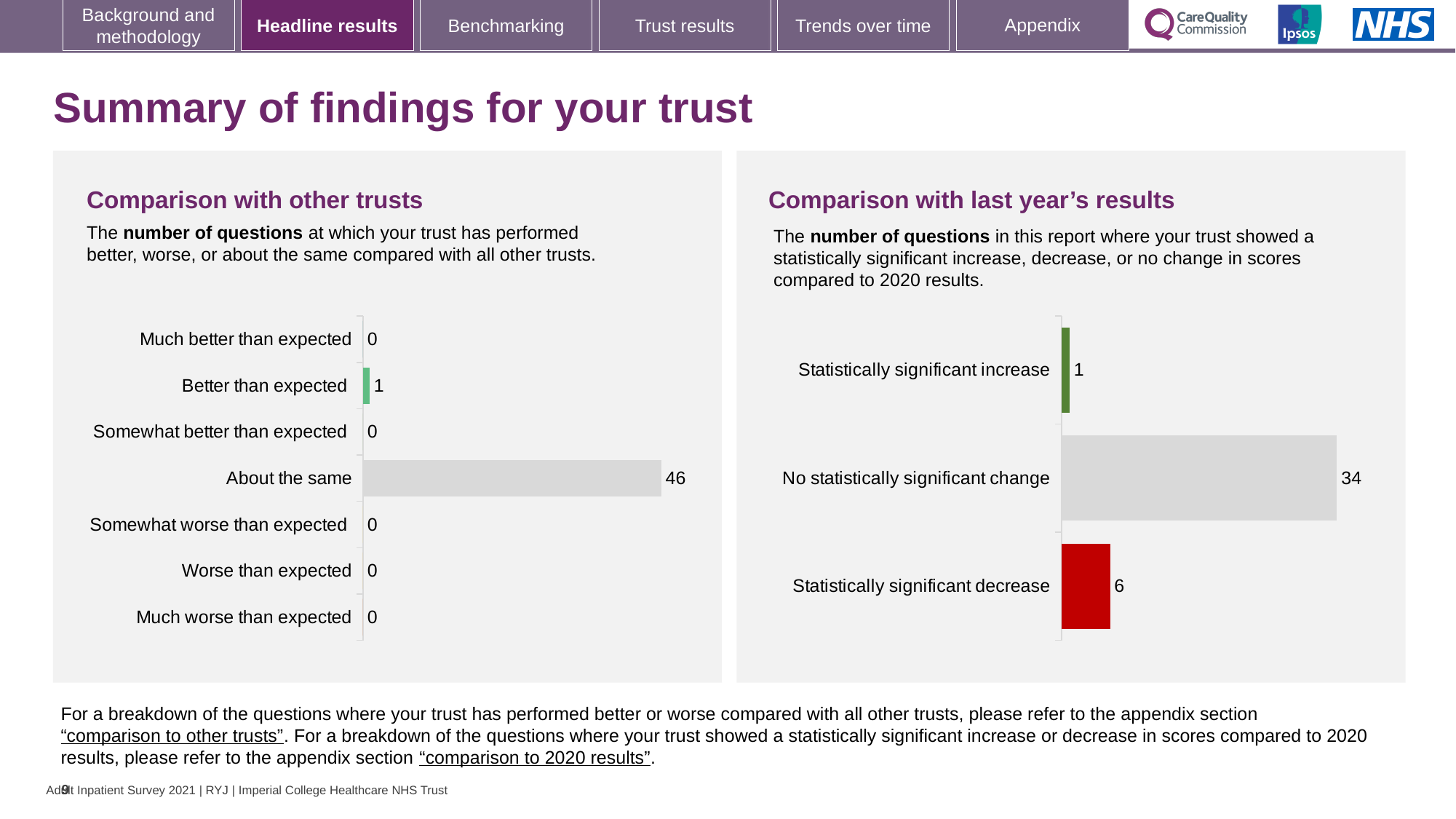
In the 'Comparison with last year's results' chart, is the value for 'Statistically significant decrease' larger or smaller than the value for 'Statistically significant increase'? larger In the 'Comparison with last year's results' chart, what is the value for 'Statistically significant decrease'? 6 In the 'Comparison with last year's results' chart, what colour is the bar for 'Statistically significant decrease'? red In the 'Comparison with other trusts' chart, what is the difference between 'About the same' and 'Better than expected'? 45 In the 'Comparison with other trusts' chart, which category has the highest value? About the same What type of chart is the 'Comparison with last year's results' chart? bar chart How many categories are shown in the 'Comparison with other trusts' chart? 7 In the 'Comparison with last year's results' chart, what is the difference between 'No statistically significant change' and 'Statistically significant decrease'? 28 In the 'Comparison with other trusts' chart, what is the value for 'Better than expected'? 1 In the 'Comparison with other trusts' chart, what is the value for 'About the same'? 46 In the 'Comparison with last year's results' chart, which category has the lowest value? Statistically significant increase In the 'Comparison with last year's results' chart, what is the value for 'No statistically significant change'? 34